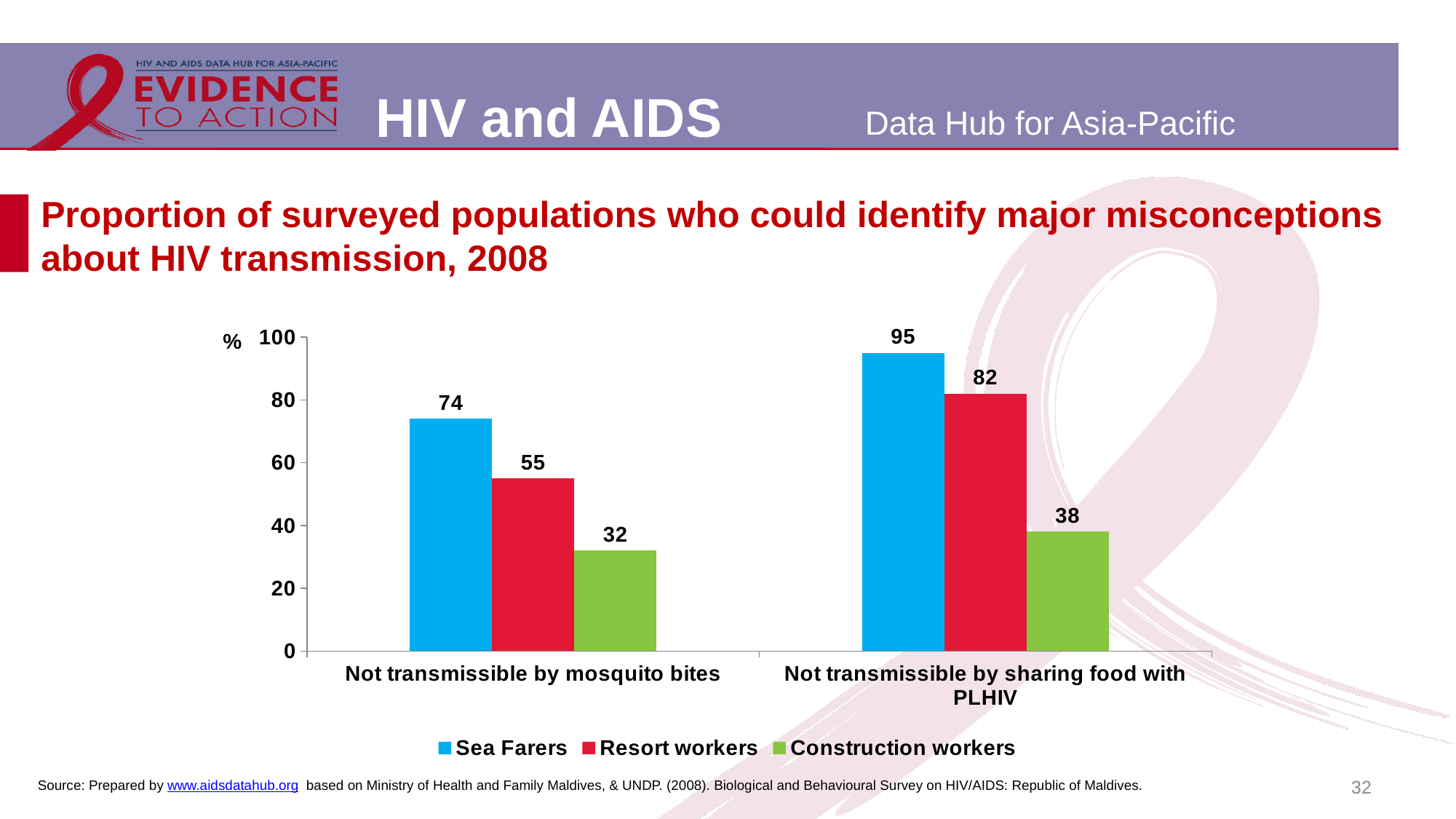
What is the value for Resort workers in the 'Not transmissible by mosquito bites' category? 55 Which series has the highest value in the 'Not transmissible by sharing food with PLHIV' category? Sea Farers What is the value for Sea Farers in the 'Not transmissible by mosquito bites' category? 74 Which series has the lowest value in the 'Not transmissible by mosquito bites' category? Construction workers Which is larger: Resort workers for 'Not transmissible by mosquito bites' or Construction workers for 'Not transmissible by sharing food with PLHIV'? Resort workers for 'Not transmissible by mosquito bites' What kind of chart is shown on the slide? Bar chart How many categories are shown on the x axis? 2 What is the difference between the Sea Farers and Resort workers values in the 'Not transmissible by sharing food with PLHIV' category? 13 What is the value for Construction workers in the 'Not transmissible by sharing food with PLHIV' category? 38 What is the difference between the Sea Farers values for the two categories? 21 How many series does the legend list? 3 What colour represents Construction workers in the chart? Green